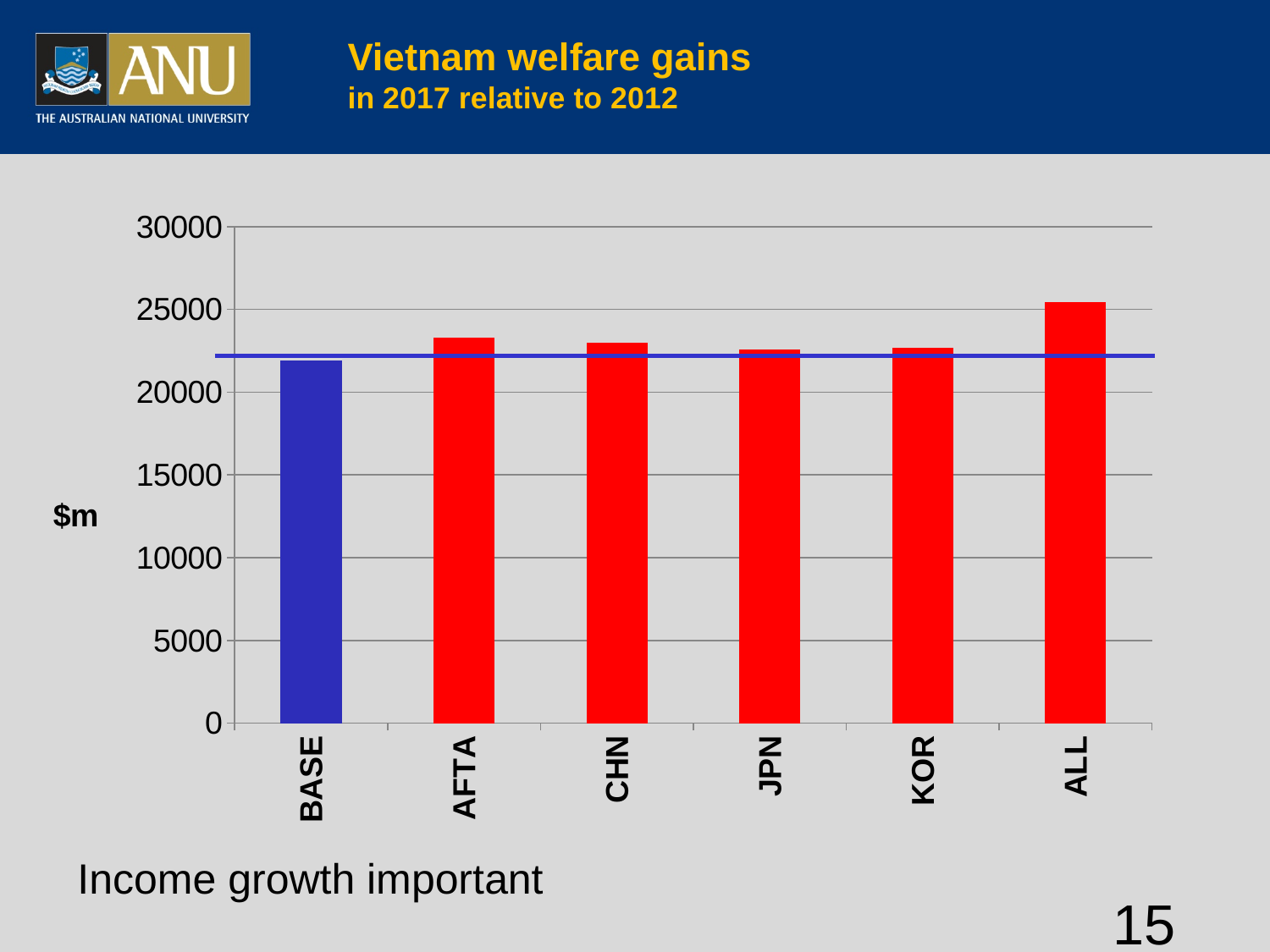
Which category has the lowest value in the chart? BASE What colour is the BASE bar in the chart? blue Is the value for ALL greater or less than 30000? less Which is larger, the value for ALL or the value for BASE? ALL Which category has the highest value in the chart? ALL Is the value for BASE greater or less than 20000? greater What is the label on the vertical axis of the chart? $m Which is larger, the value for ALL or the value for AFTA? ALL What kind of chart is shown on the slide? bar chart Is the value for JPN greater or less than 20000? greater How many categories are shown on the x axis of the chart? 6